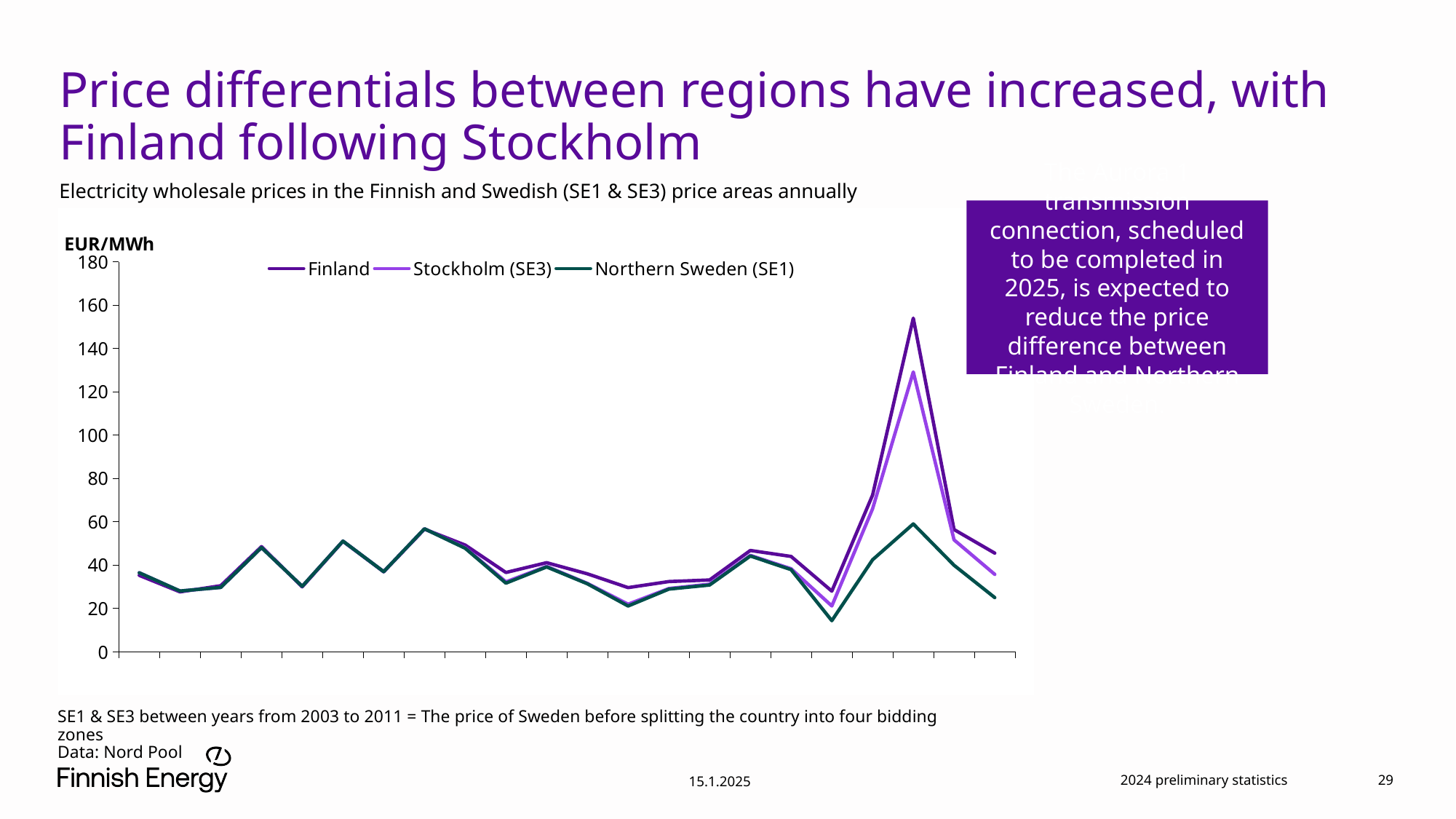
Is the lowest value of the Northern Sweden (SE1) line greater or less than 20? less What kind of chart is shown on the slide? line chart How many series does the chart legend list? 3 Which series are listed in the chart legend? Finland, Stockholm (SE3), Northern Sweden (SE1) What unit is shown on the chart's vertical axis? EUR/MWh Is the peak value of the Stockholm (SE3) line greater or less than 120? greater Is the peak value of the Northern Sweden (SE1) line greater or less than 80? less At the last point on the chart, which is larger: the Stockholm (SE3) value or the Northern Sweden (SE1) value? Stockholm (SE3) Which series reaches the lowest value on the chart? Northern Sweden (SE1) At the chart's highest peak, which is larger: the Finland value or the Stockholm (SE3) value? Finland Which series reaches the highest value on the chart? Finland